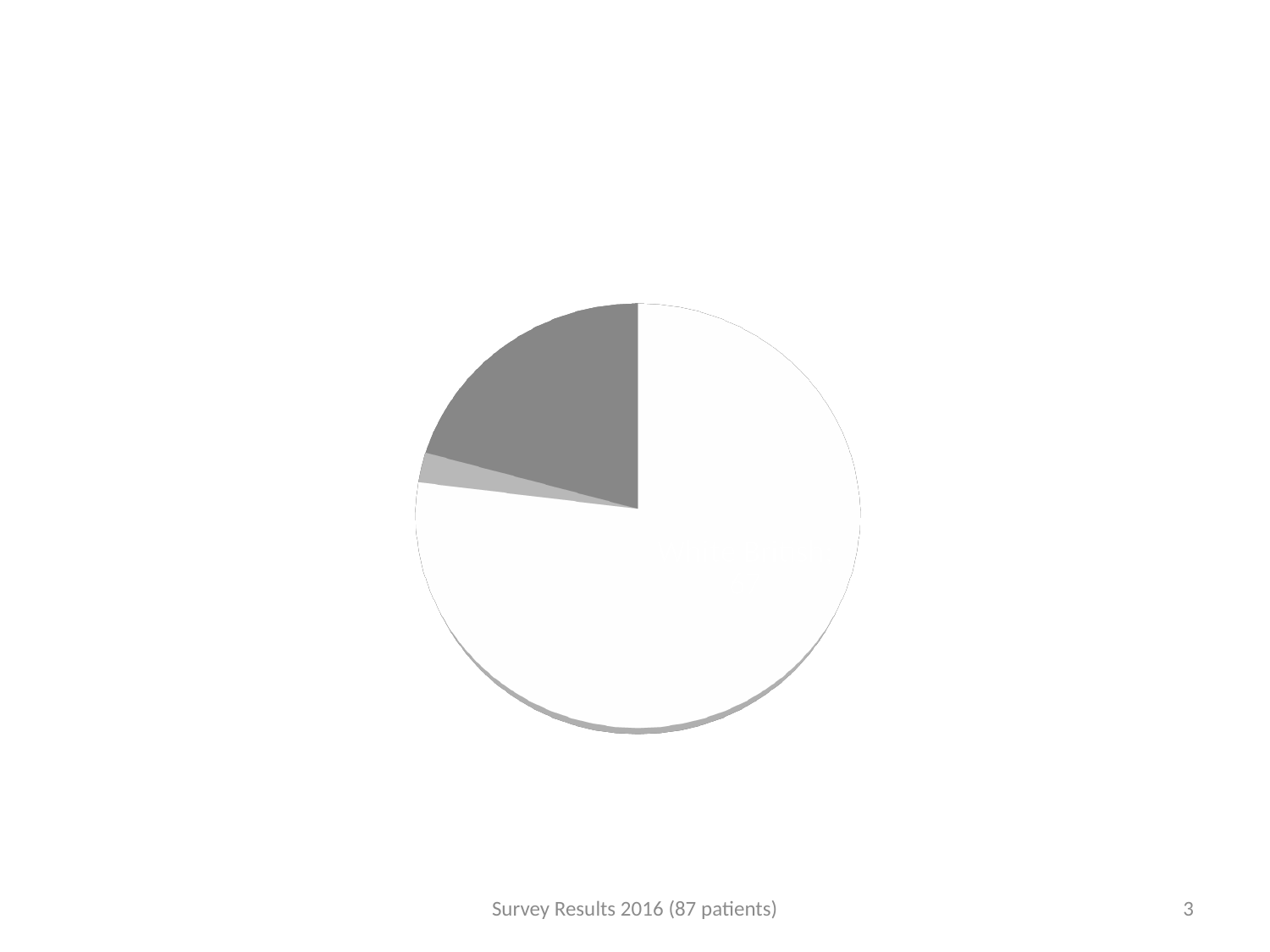
Which slice of the pie chart is the smallest? the light grey slice Does the pie chart show data labels on its slices? No Which slice of the pie chart is the largest? the white slice Does the pie chart display a legend? No Which is larger in the pie chart, the white slice or the dark grey slice? the white slice What kind of chart is shown on the slide? pie chart Does the white slice take up more or less than half of the pie chart? more How many slices does the pie chart have? 3 Which is larger in the pie chart, the dark grey slice or the light grey slice? the dark grey slice